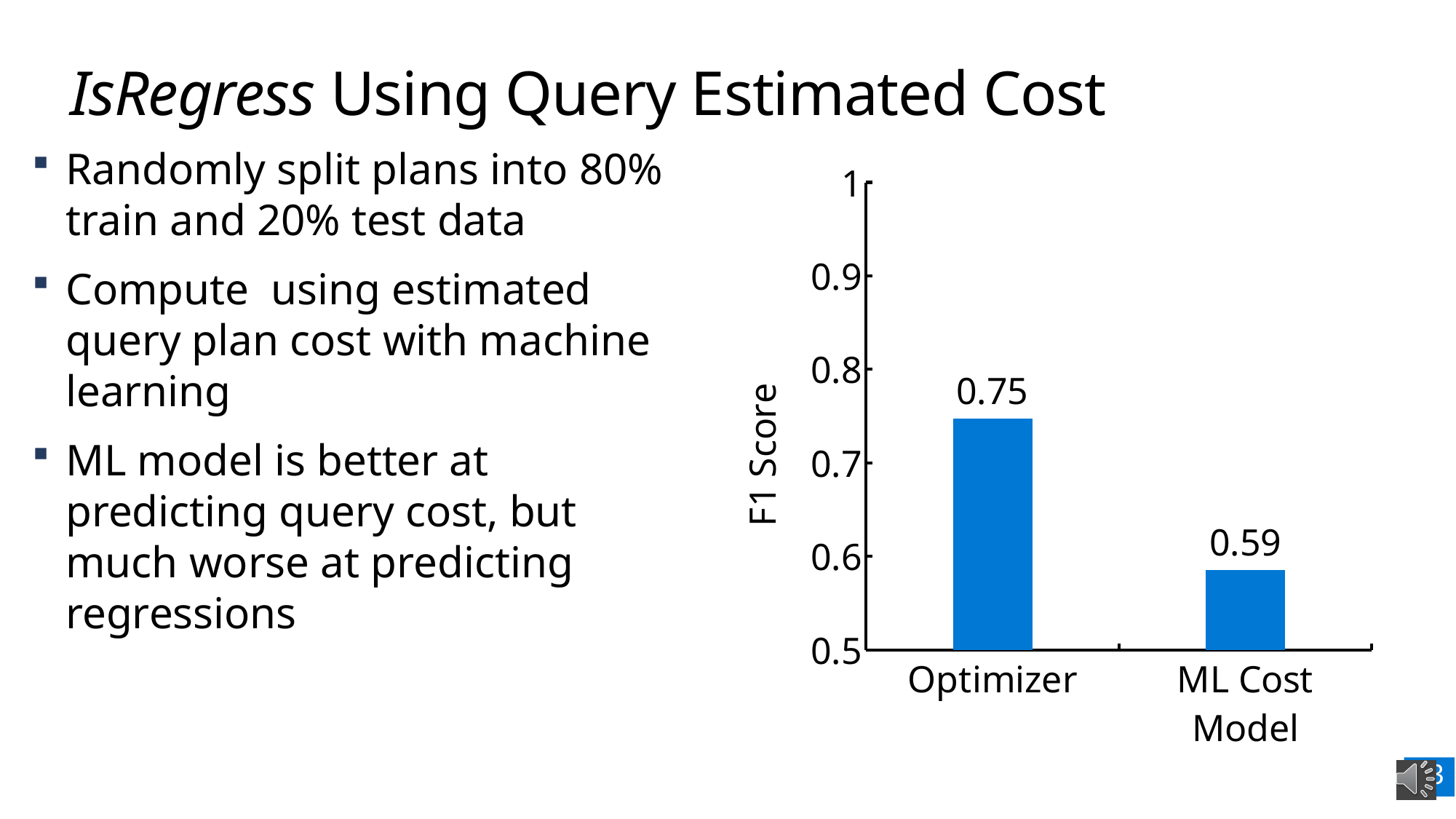
What is the difference in F1 Score between Optimizer and ML Cost Model? 0.16 Which category has the highest F1 Score? Optimizer What is the F1 Score for Optimizer? 0.75 What is the F1 Score for ML Cost Model? 0.59 Which has a larger F1 Score, Optimizer or ML Cost Model? Optimizer Which category has the lowest F1 Score? ML Cost Model What kind of chart is shown on the slide? bar chart Is the F1 Score for Optimizer greater or less than 0.7? greater Is the F1 Score for ML Cost Model greater or less than 0.6? less What is the label of the vertical axis of the chart? F1 Score What is the lowest value shown on the vertical axis of the chart? 0.5 How many categories are shown in the chart? 2